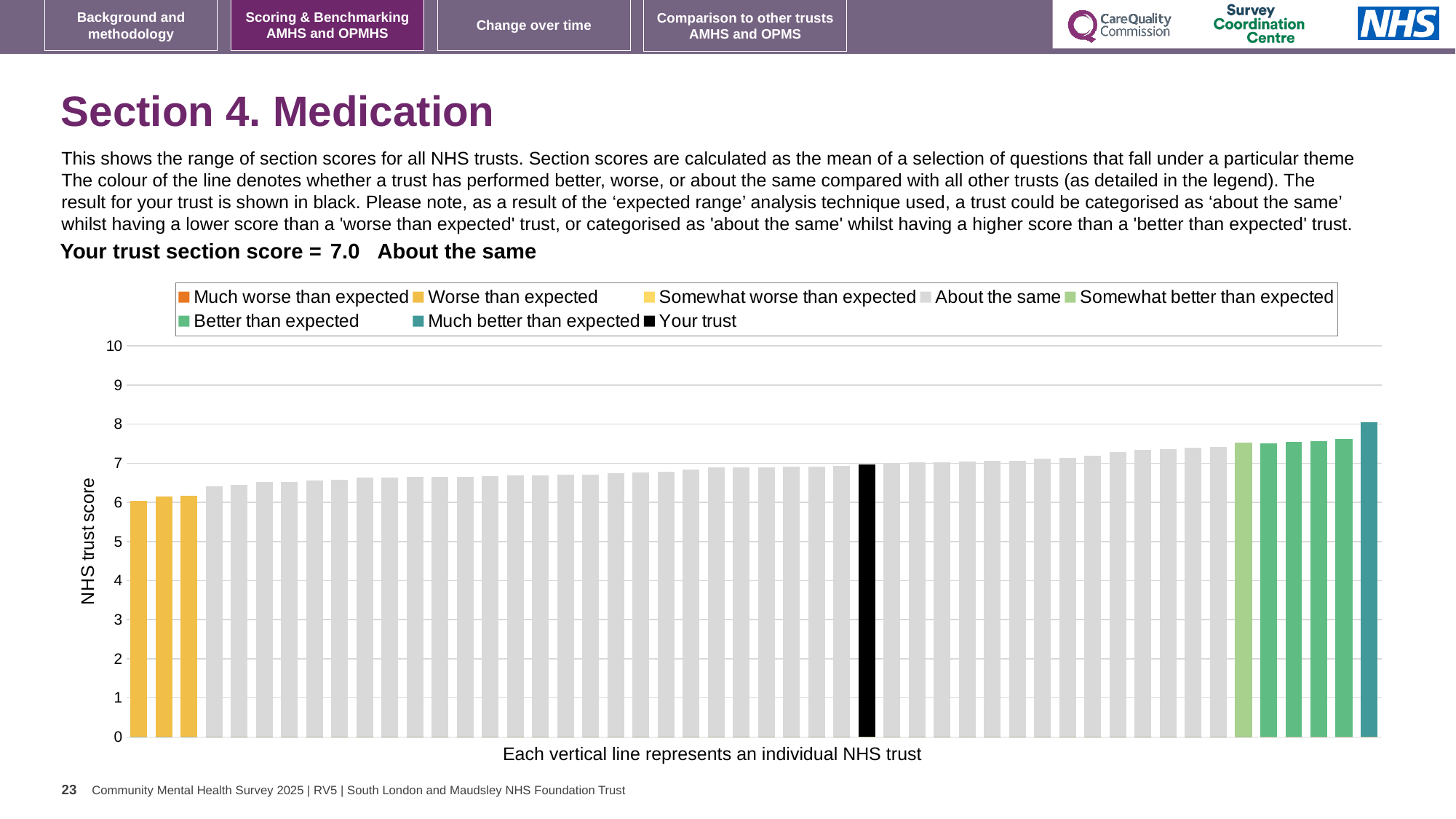
Is the value of the black 'Your trust' bar greater or less than 6? greater Is the 'Your trust' bar taller or shorter than the 'Worse than expected' bars? taller What kind of chart is shown on the slide? bar chart What is the label on the vertical axis of the chart? NHS trust score Which legend category is your trust placed in for this section? About the same Which legend category does the tallest bar on the chart belong to? Much better than expected How many bars are coloured in the 'Worse than expected' colour? 3 What is the section score for your trust shown on the slide? 7.0 Is the value of the lowest bar on the chart greater or less than 7? less Do the bar values rise or fall from left to right along the x axis? rise How many entries does the chart legend list? 8 Is the value of the tallest bar on the chart greater or less than 7? greater